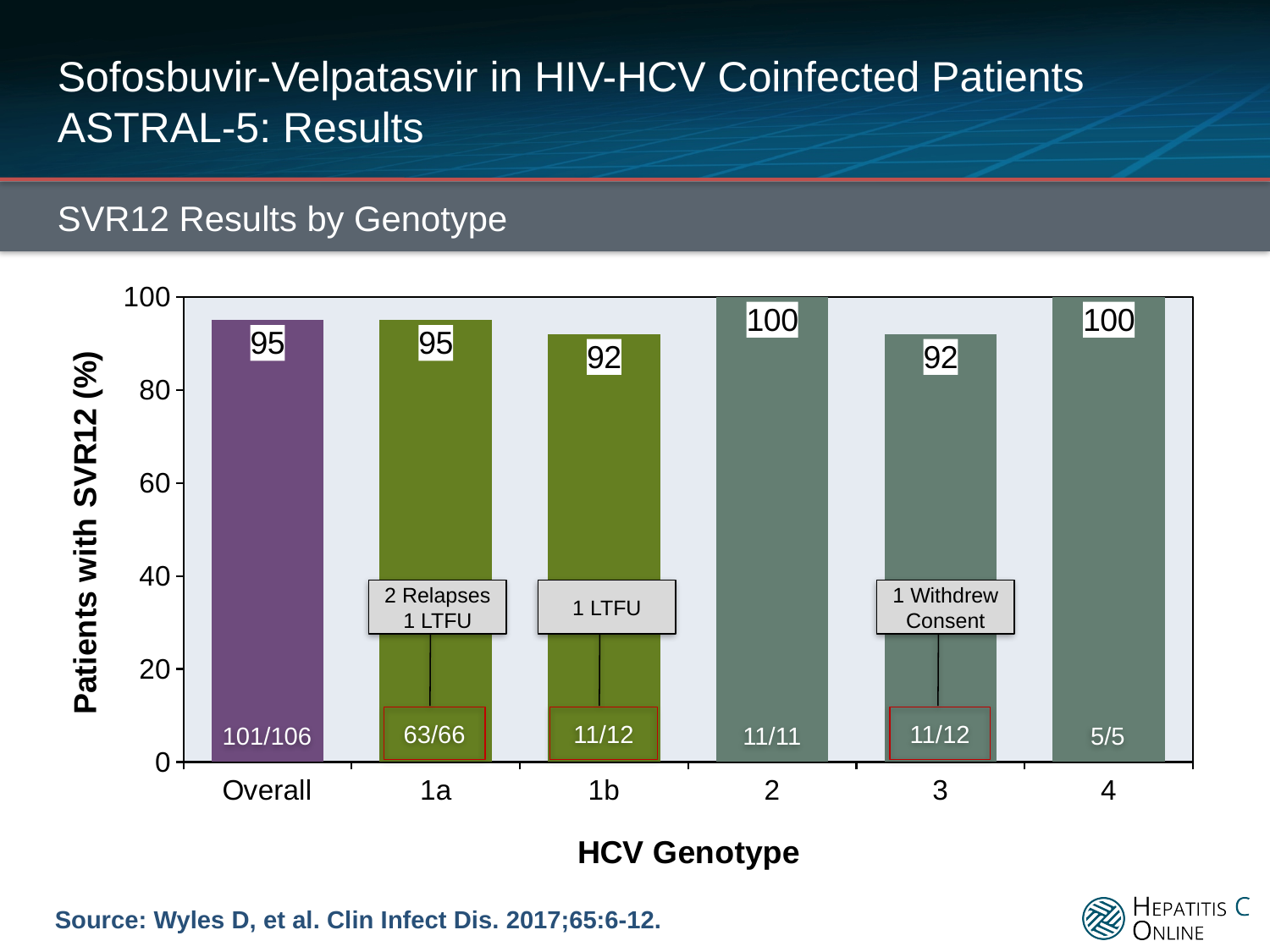
How many categories are shown on the x axis? 6 What is the difference in SVR12 rate between genotype 2 and genotype 3? 8 Which has a higher SVR12 rate, genotype 1a or genotype 1b? 1a What is the SVR12 rate for genotype 3? 92 What fraction of patients is shown at the base of the genotype 1a bar? 63/66 What is the SVR12 rate for the Overall group? 95 What kind of chart is shown on the slide? Bar chart Which genotypes have the highest SVR12 rate? 2 and 4 What fraction of patients is shown at the base of the Overall bar? 101/106 What annotation is attached to the genotype 3 bar? 1 Withdrew Consent What is the label of the y axis? Patients with SVR12 (%) What is the SVR12 rate for genotype 1b? 92